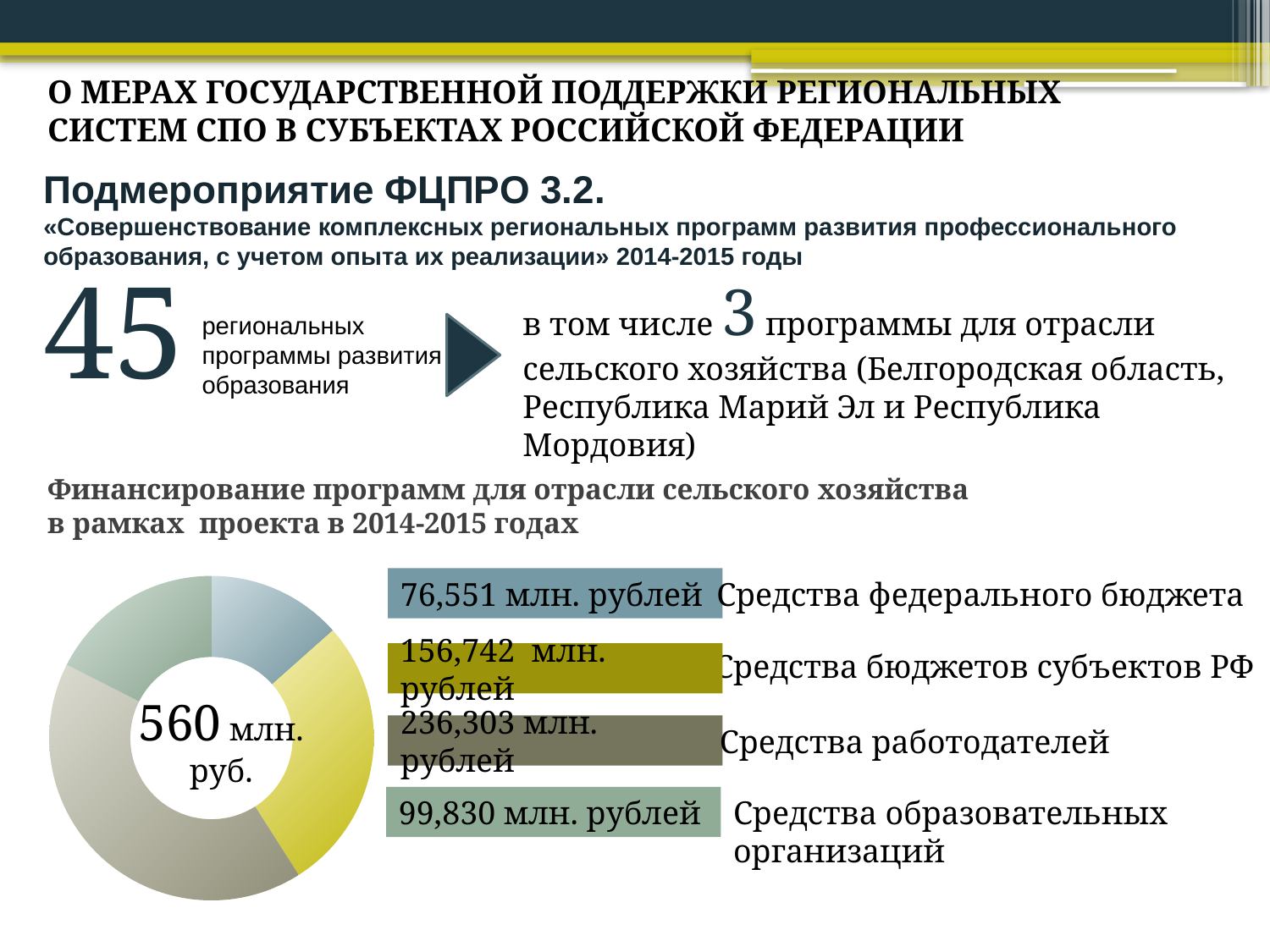
What kind of chart is used to show the funding of agricultural programmes? Doughnut chart How many funding sources are shown in the doughnut chart? 4 What is the difference between Средства образовательных организаций and Средства федерального бюджета? 23,279 млн. рублей What is the value for Средства образовательных организаций in the doughnut chart? 99,830 млн. рублей What is the value for Средства федерального бюджета in the doughnut chart? 76,551 млн. рублей What is the value for Средства бюджетов субъектов РФ in the doughnut chart? 156,742 млн. рублей What is the value for Средства работодателей in the doughnut chart? 236,303 млн. рублей Which funding source has the smallest value in the doughnut chart? Средства федерального бюджета What is the difference between Средства работодателей and Средства бюджетов субъектов РФ? 79,561 млн. рублей What total value is printed in the centre of the doughnut chart? 560 млн. руб. Which is larger: Средства бюджетов субъектов РФ or Средства образовательных организаций? Средства бюджетов субъектов РФ Which funding source has the largest value in the doughnut chart? Средства работодателей